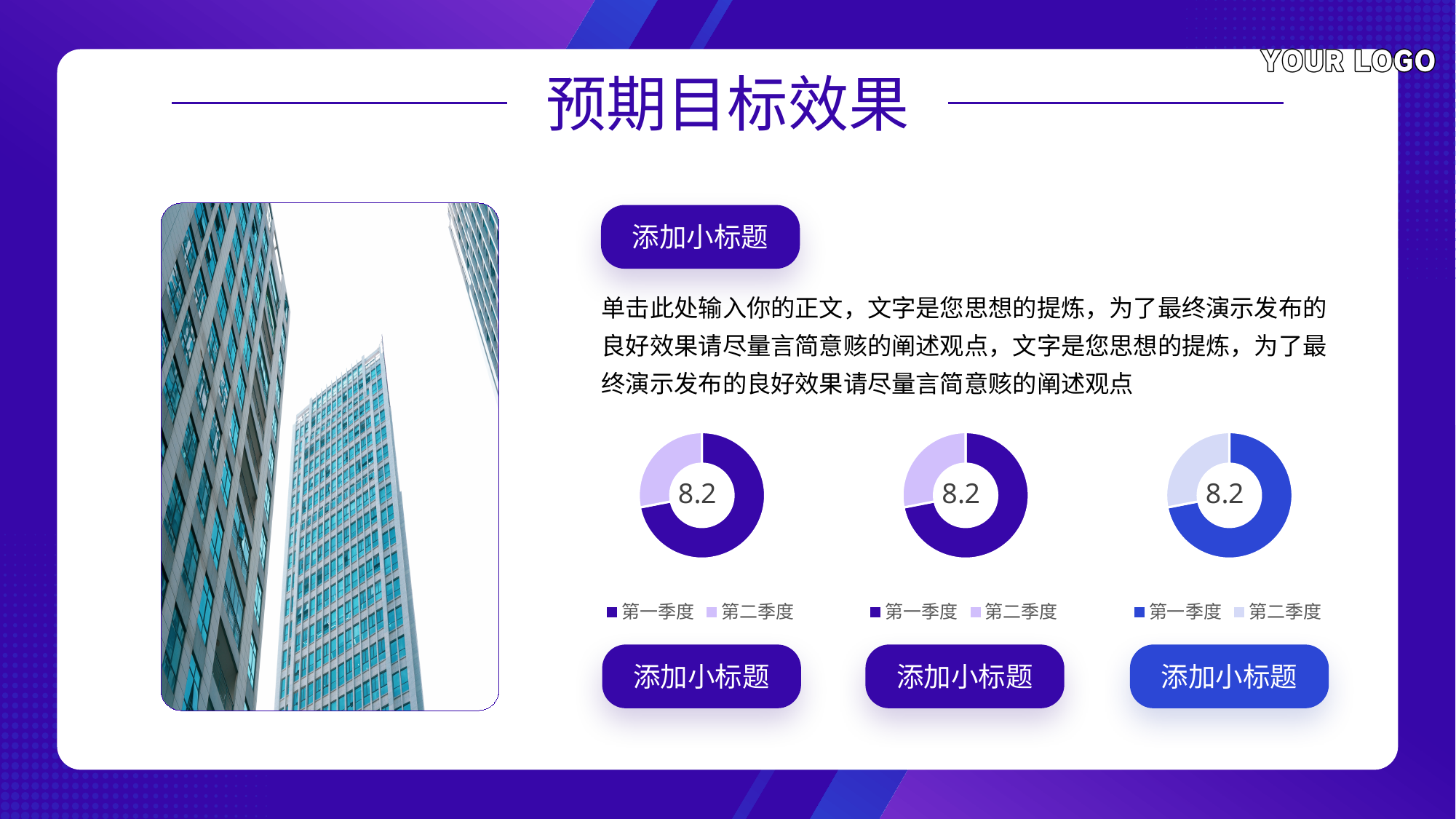
In the right donut chart, which slice is the smallest? 第二季度 In the left donut chart, which slice is larger, 第一季度 or 第二季度? 第一季度 How many series does the legend of the right donut chart list? 2 In the middle donut chart, which slice is larger, 第一季度 or 第二季度? 第一季度 How many donut charts are shown on the slide? 3 What number is printed in the center of the right donut chart? 8.2 In the middle donut chart, which slice is the largest? 第一季度 What kind of chart is the left chart on the slide? Donut chart How many slices does the right donut chart have? 2 How many series does the legend of the left donut chart list? 2 What number is printed in the center of the left donut chart? 8.2 What are the two legend entries of the middle donut chart? 第一季度, 第二季度